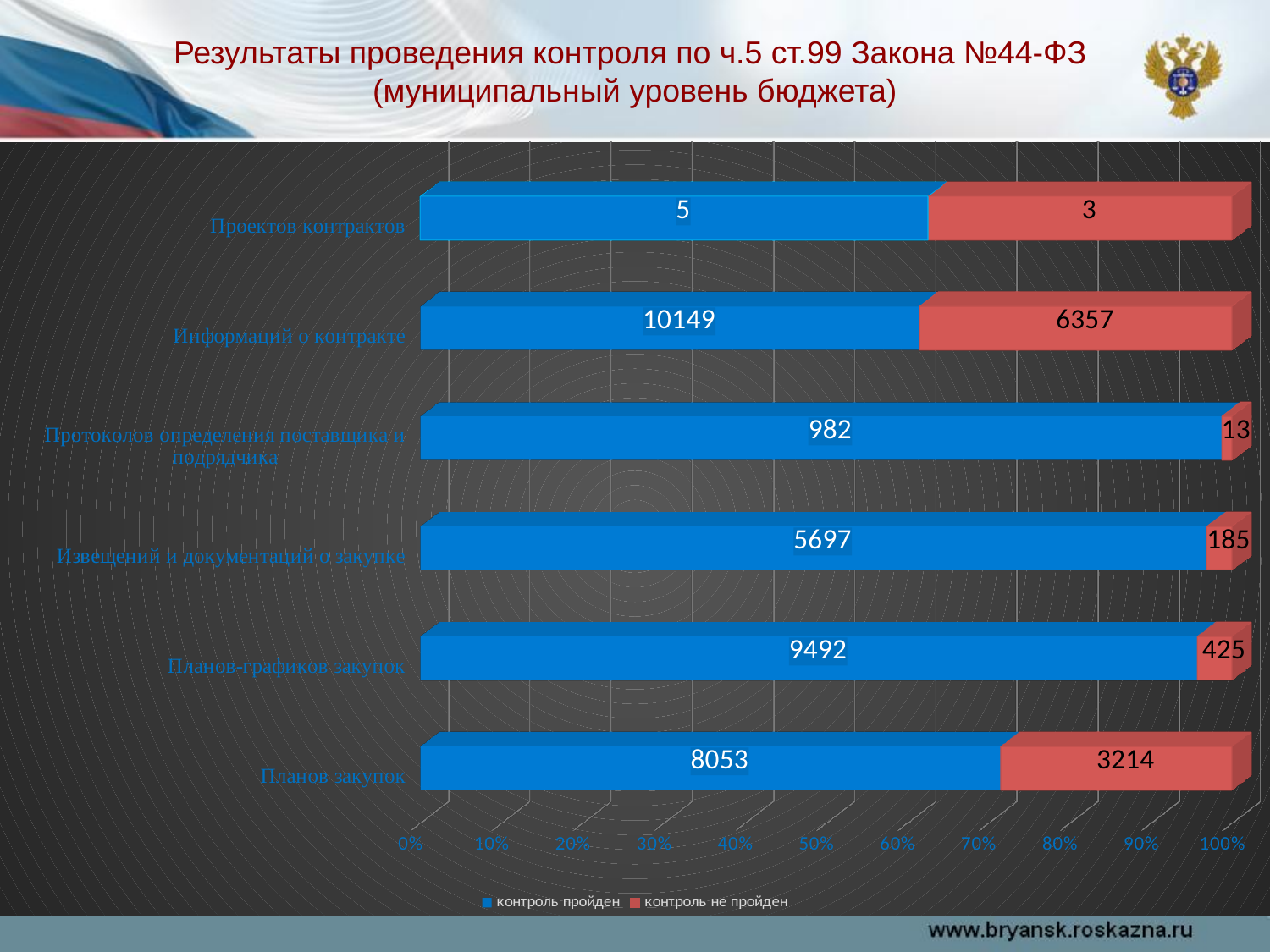
What is the value of "контроль пройден" for "Информаций о контракте"? 10149 Which is larger for "Протоколов определения поставщика и подрядчика": "контроль пройден" or "контроль не пройден"? контроль пройден What is the difference between "контроль пройден" and "контроль не пройден" for "Планов закупок"? 4839 How many categories are shown in the chart? 6 What is the value of "контроль не пройден" for "Планов закупок"? 3214 What kind of chart is shown on the slide? Stacked bar chart Which category has the highest value of "контроль не пройден"? Информаций о контракте Which category has the lowest value of "контроль пройден"? Проектов контрактов What is the value of "контроль пройден" for "Извещений и документаций о закупке"? 5697 What is the value of "контроль не пройден" for "Планов-графиков закупок"? 425 How many series does the legend list? 2 What is the total of the two values in the bar for "Проектов контрактов"? 8